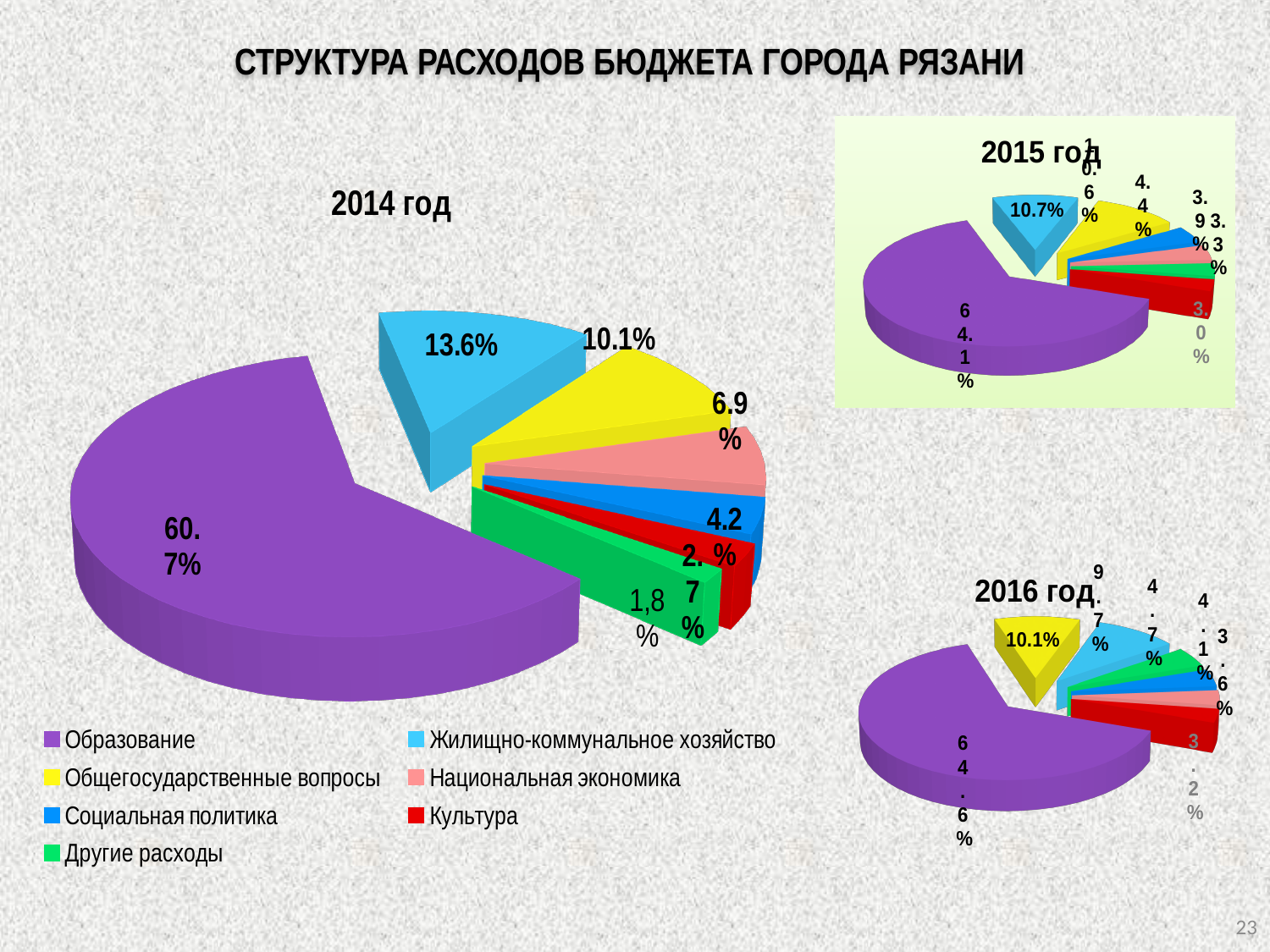
In the 2014 год chart, what is the difference between Жилищно-коммунальное хозяйство and Общегосударственные вопросы? 3.5% In the 2014 год chart, what is the value for Общегосударственные вопросы? 10.1% In the 2014 год chart, what is the value for Жилищно-коммунальное хозяйство? 13.6% In the 2014 год chart, which is larger: Социальная политика or Культура? Социальная политика In the 2015 год chart, what share does Образование have? 64.1% In the 2016 год chart, what is the value for Образование? 64.6% How many categories does the legend list? 7 In the 2014 год chart, which category has the smallest slice? Другие расходы In the 2014 год chart, what share does Образование have? 60.7% What kind of chart is used for the 2014 год chart? pie chart In the 2014 год chart, which category has the largest slice? Образование In the 2014 год chart, what is the value for Национальная экономика? 6.9%